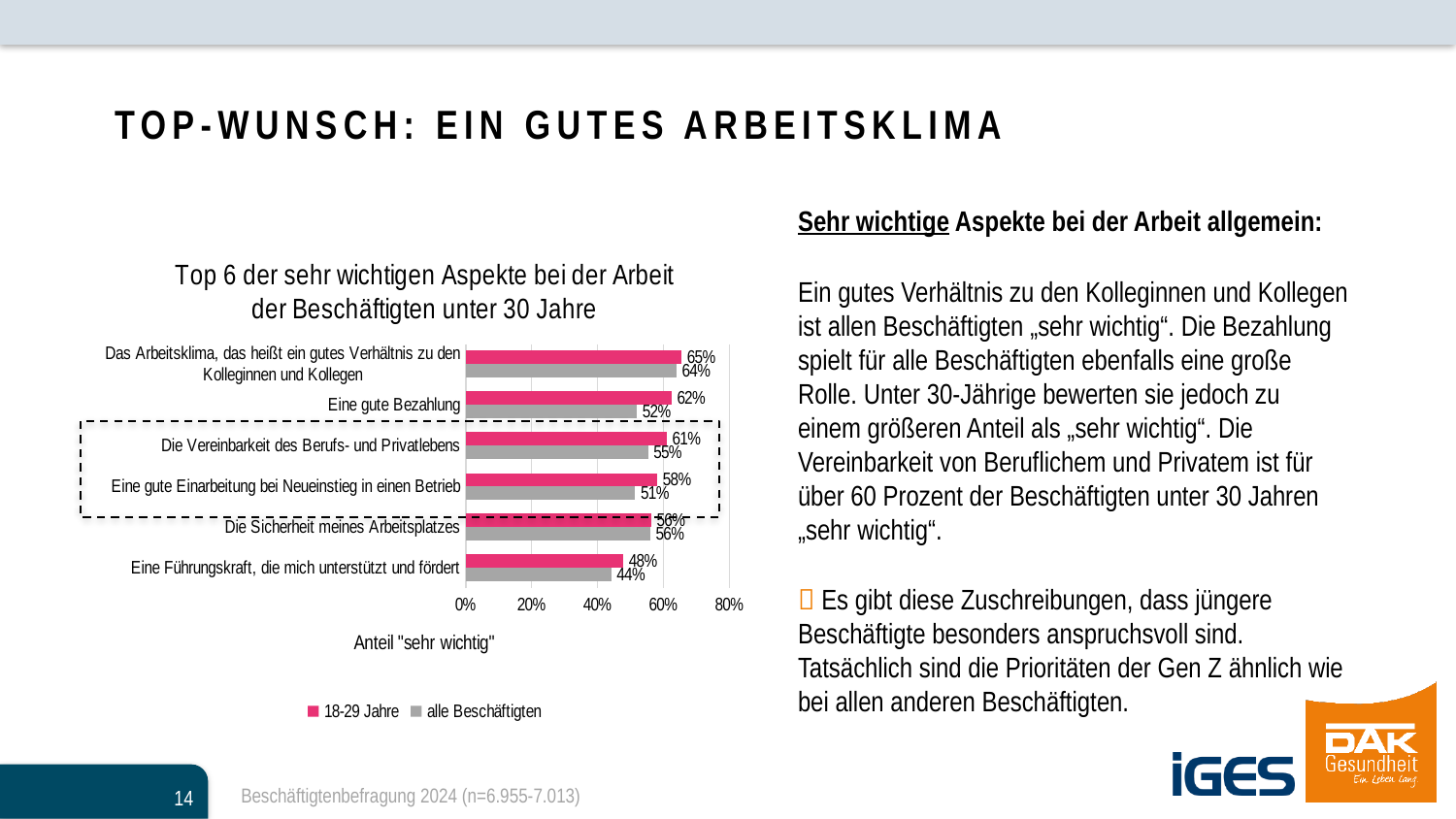
How many series does the chart legend list? 2 What is the value for "alle Beschäftigten" for "Eine gute Bezahlung"? 52% What is the value for "alle Beschäftigten" for "Eine Führungskraft, die mich unterstützt und fördert"? 44% What is the difference between the "18-29 Jahre" and "alle Beschäftigten" values for "Eine gute Bezahlung"? 10% What kind of chart is shown on the slide? bar chart What is the title of the chart? Top 6 der sehr wichtigen Aspekte bei der Arbeit der Beschäftigten unter 30 Jahre What is the value for "18-29 Jahre" for "Das Arbeitsklima, das heißt ein gutes Verhältnis zu den Kolleginnen und Kollegen"? 65% What is the value for "18-29 Jahre" for "Die Vereinbarkeit des Berufs- und Privatlebens"? 61% How many categories (aspects) are shown in the chart? 6 Which category has the highest value for "18-29 Jahre"? Das Arbeitsklima, das heißt ein gutes Verhältnis zu den Kolleginnen und Kollegen Which category has the lowest value for "alle Beschäftigten"? Eine Führungskraft, die mich unterstützt und fördert For "Eine gute Einarbeitung bei Neueinstieg in einen Betrieb", which series has the larger value, "18-29 Jahre" or "alle Beschäftigten"? 18-29 Jahre